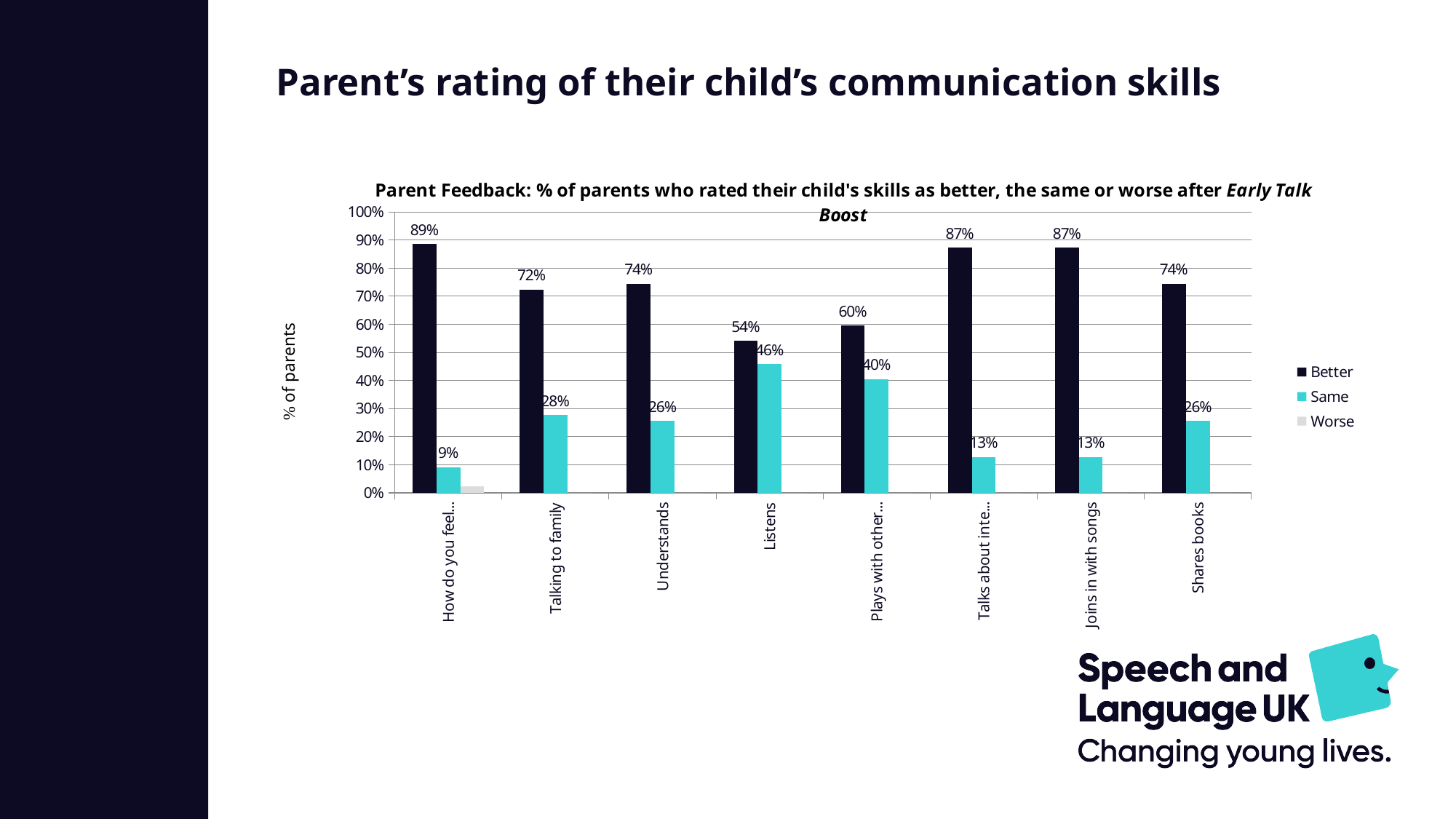
Is the Worse value for the first category greater or less than 10%? less What percentage of parents rated their child's skills as Better for Talking to family? 72% How many series does the legend list? 3 For Understands, how much higher is the Better value than the Same value? 48 percentage points How many categories are shown on the x axis? 8 What is the Same value for Listens? 46% Which category has the lowest Better value? Listens What is the Better value for Shares books? 74% Which category has the highest Same value? Listens Which has the larger Better value: Joins in with songs or Shares books? Joins in with songs What kind of chart is shown on the slide? Bar chart What is the Same value for Joins in with songs? 13%